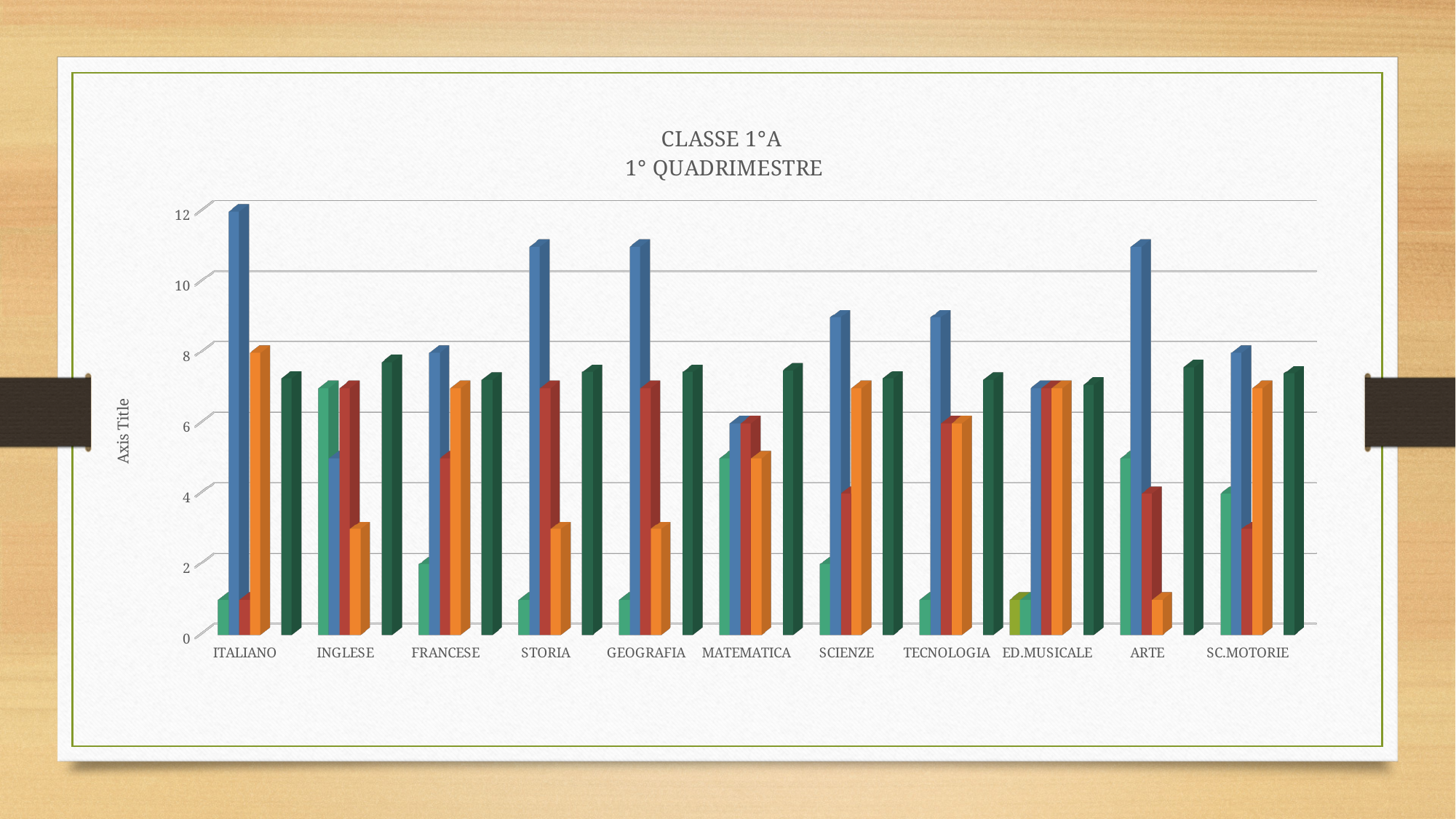
Is the value of the orange bar for INGLESE greater or less than 4? less What is the title of the chart? CLASSE 1°A 1° QUADRIMESTRE Is the value of the blue bar for STORIA greater or less than 10? greater How many subject categories are shown on the x axis of the chart? 11 Is the value of the orange bar for ITALIANO greater or less than 6? greater Which is larger: the blue bar for ITALIANO or the blue bar for MATEMATICA? ITALIANO What label is shown on the vertical axis of the chart? Axis Title Which category has the tallest blue bar? ITALIANO What kind of chart is shown on the slide? bar chart